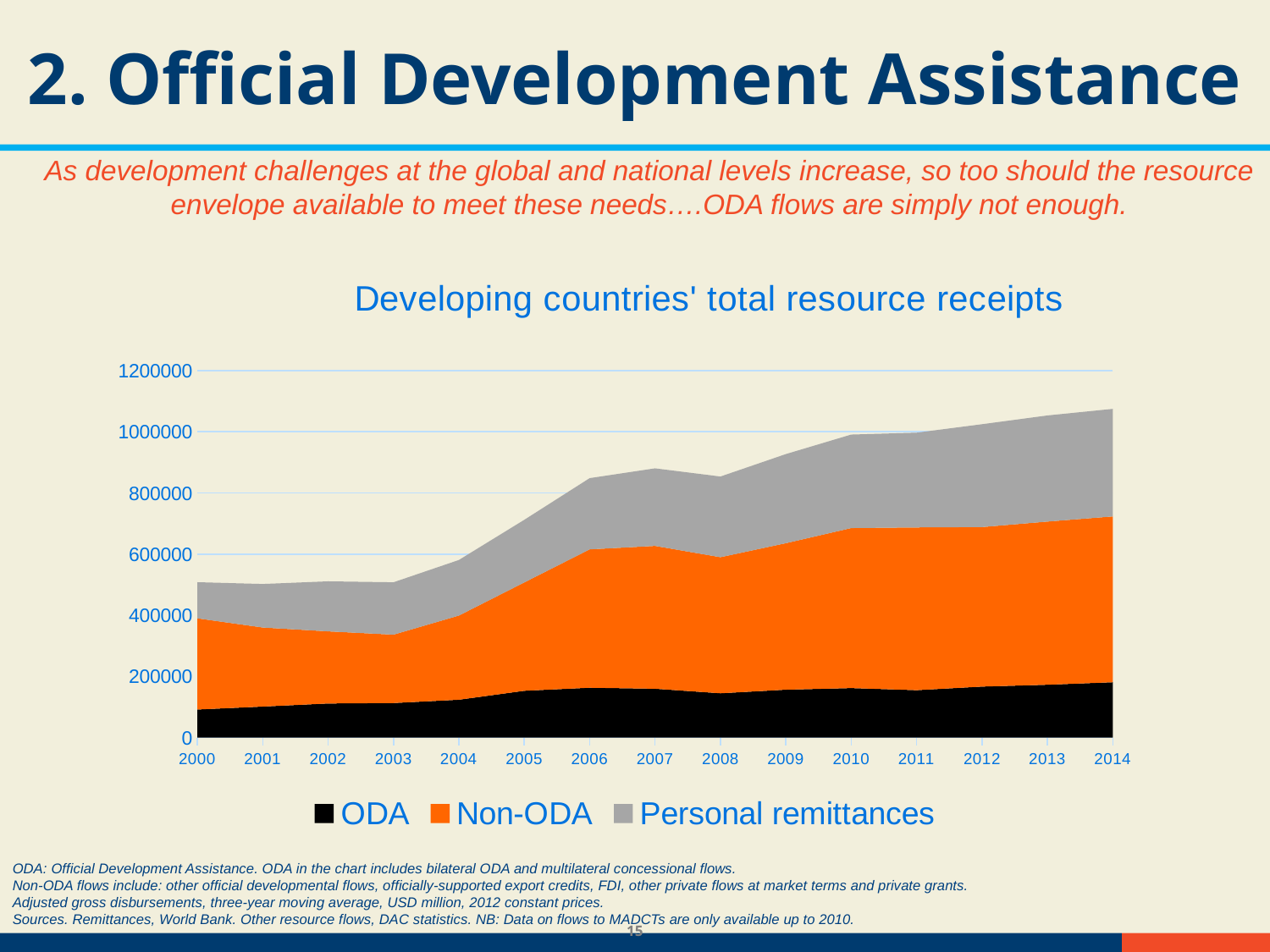
Which year has larger total resource receipts, 2005 or 2010? 2010 Which series are listed in the legend? ODA, Non-ODA, Personal remittances Do total resource receipts generally rise or fall from 2000 to 2014? Rise In which year are total resource receipts highest? 2014 What kind of chart is shown on the slide? Stacked area chart Is the total resource receipts value for 2006 greater or less than 800000? greater How many series does the legend list? 3 What is the title of the chart? Developing countries' total resource receipts Is the total resource receipts value for 2000 greater or less than 600000? less Is the total resource receipts value for 2014 greater or less than 1000000? greater How many years are shown along the x axis? 15